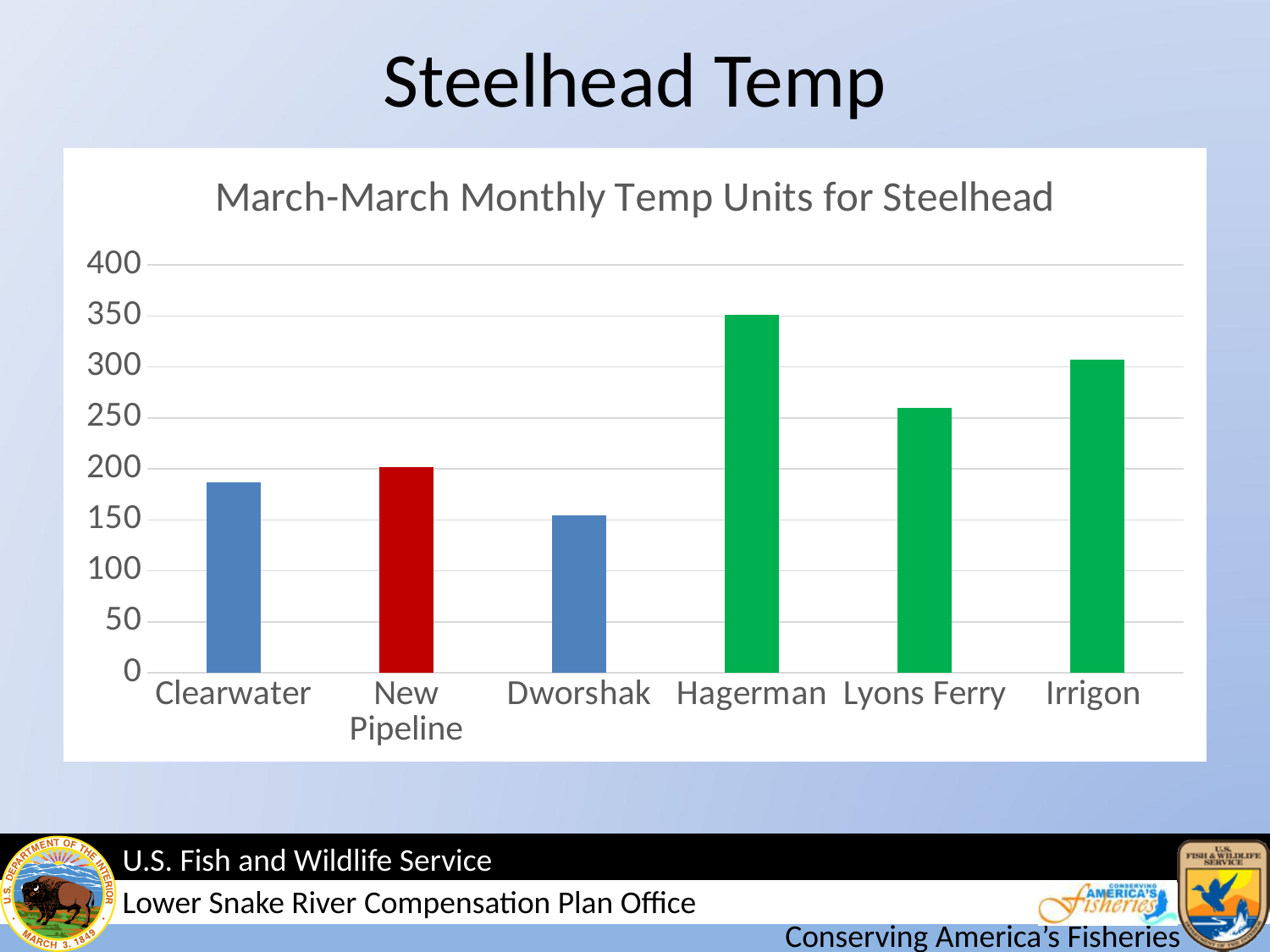
Is the value for Dworshak greater or less than 200? less What is the title of the chart? March-March Monthly Temp Units for Steelhead Which category has the highest value in the chart? Hagerman How many categories are shown on the x axis of the chart? 6 Which has a larger value, Hagerman or Irrigon? Hagerman Which category has the lowest value in the chart? Dworshak What colour is the bar for New Pipeline? red Which has a larger value, Lyons Ferry or Clearwater? Lyons Ferry What kind of chart is shown on the slide? bar chart Is the value for Irrigon greater or less than 350? less Is the value for Clearwater greater or less than 200? less